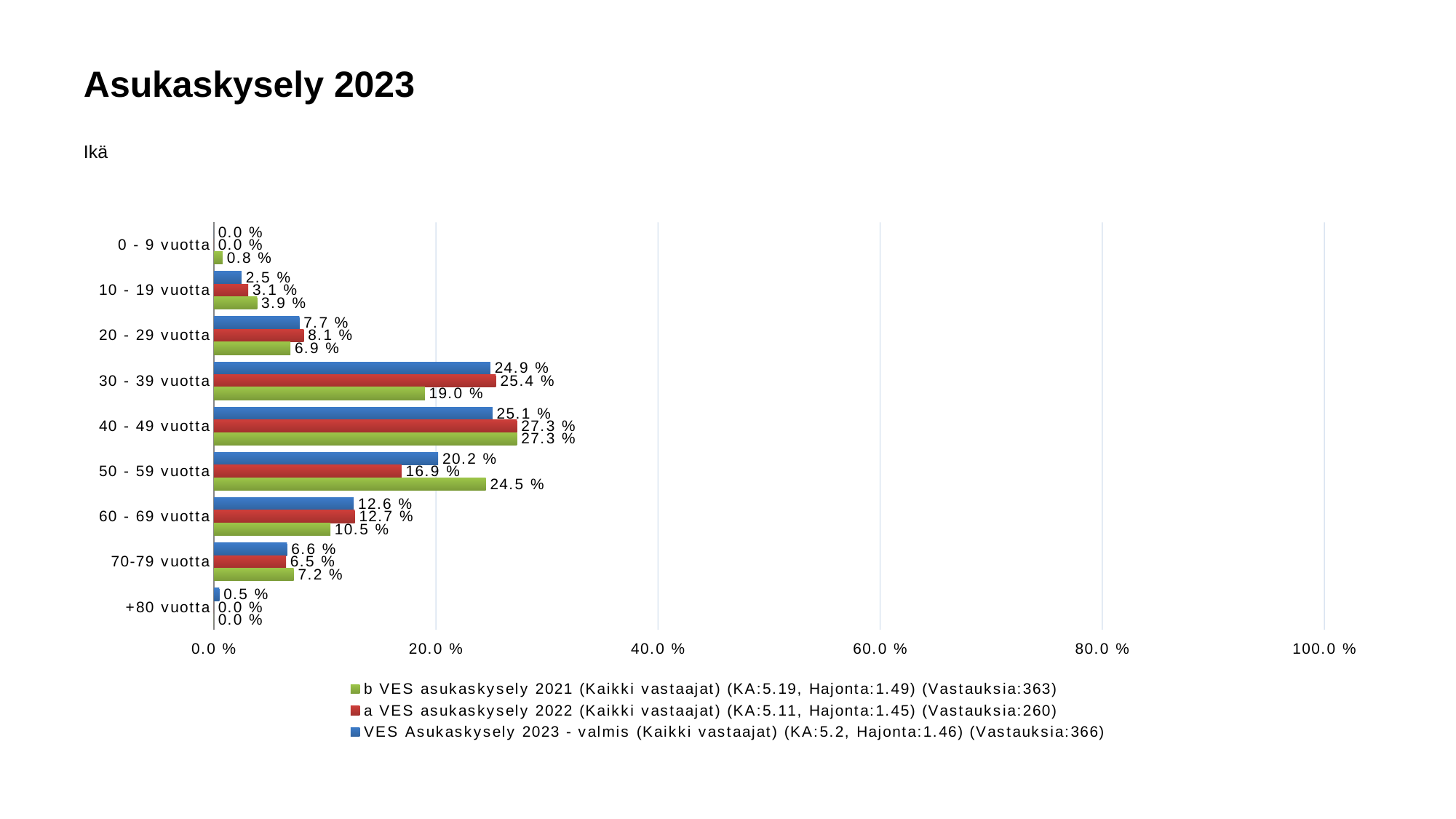
Which age category has the highest value in the VES Asukaskysely 2023 - valmis series? 40 - 49 vuotta What kind of chart is shown on the slide? Bar chart Which age category has the lowest value in the b VES asukaskysely 2021 series? +80 vuotta What is the value for 30 - 39 vuotta in the VES Asukaskysely 2023 - valmis series? 24.9 % How many age categories are shown on the chart? 9 Which colour represents the a VES asukaskysely 2022 series? Red What is the value for 60 - 69 vuotta in the b VES asukaskysely 2021 series? 10.5 % What is the difference between the 2021 and 2023 values for 50 - 59 vuotta? 4.3 % For 30 - 39 vuotta, which series has the larger value: b VES asukaskysely 2021 or a VES asukaskysely 2022? a VES asukaskysely 2022 What is the value for 50 - 59 vuotta in the a VES asukaskysely 2022 series? 16.9 % What is the value for +80 vuotta in the VES Asukaskysely 2023 - valmis series? 0.5 % How many series does the legend list? 3